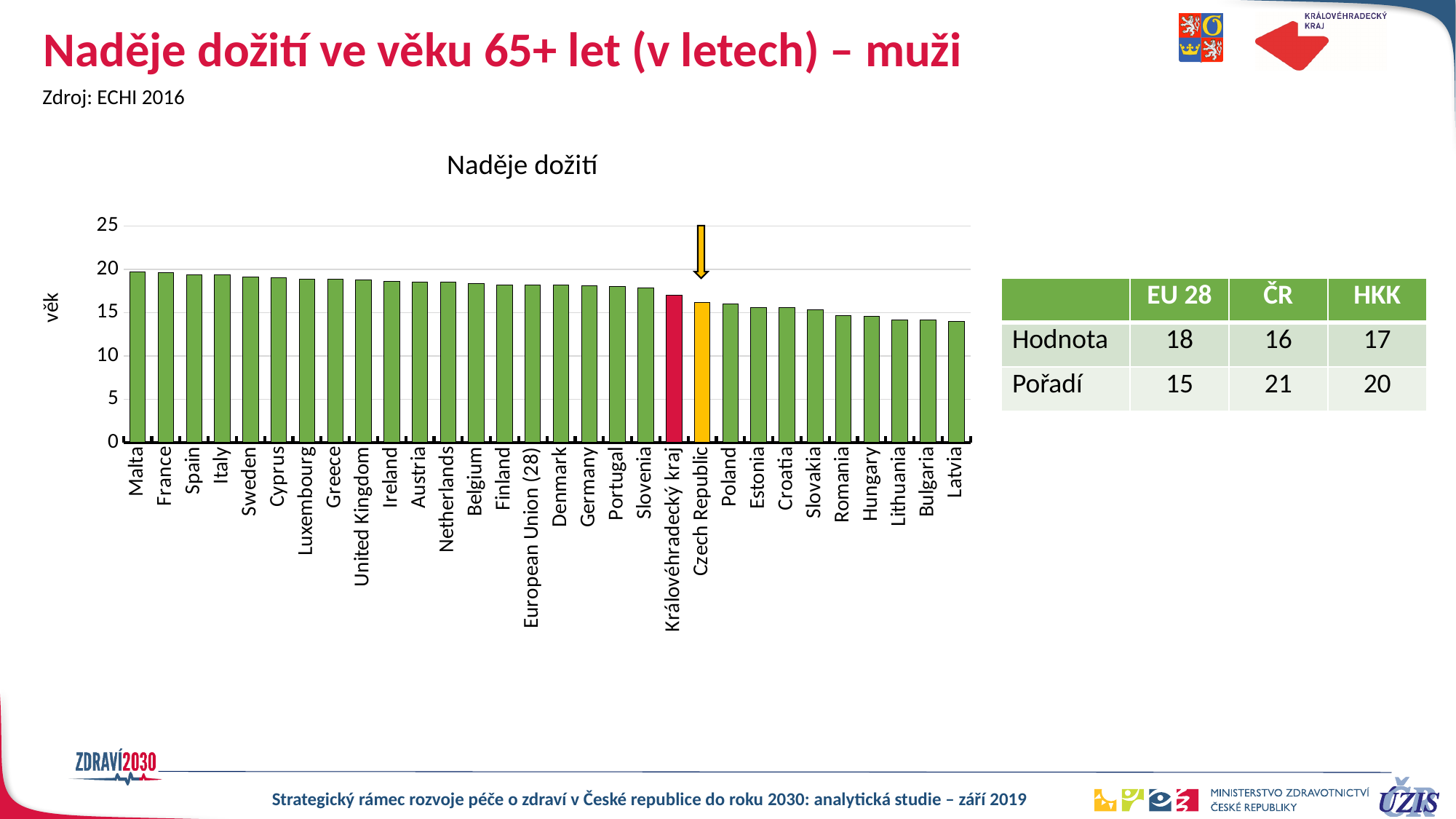
Is the value for Malta greater or less than 15? greater Is the value for Latvia greater or less than 15? less Do the bar values rise or fall from left to right along the x axis? fall Which has the larger value, Germany or Hungary? Germany How many countries/regions are plotted on the x axis of the chart? 30 Is the value for Hungary greater or less than 20? less What kind of chart is shown on the slide? bar chart Which has the larger value, Malta or Latvia? Malta What is the label of the y axis of the chart? věk What is the title of the chart? Naděje dožití